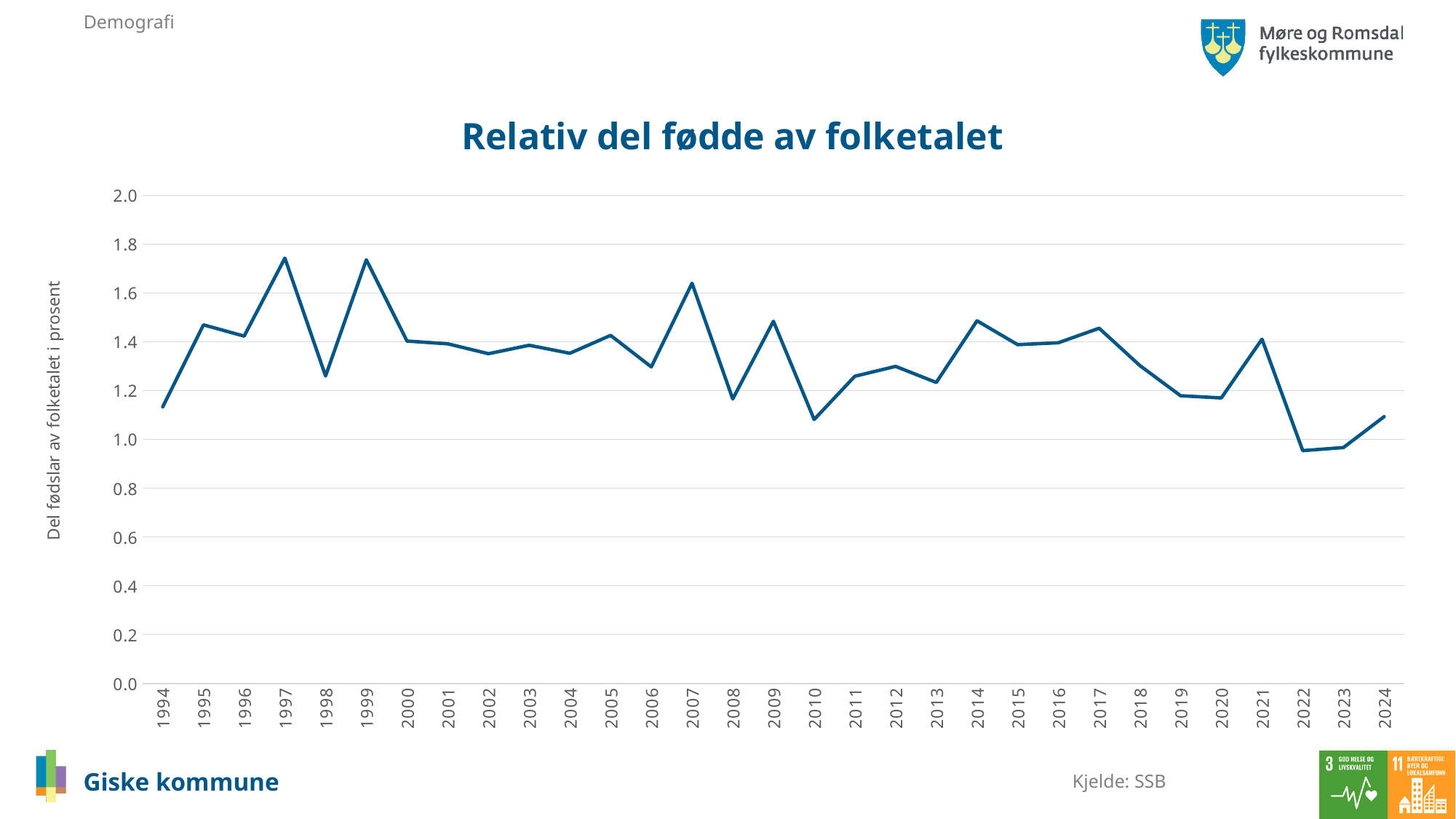
Is the value for 1994 greater or less than 1.0? greater Which year has the larger value, 2021 or 2022? 2021 Is the value for 1997 greater or less than 1.6? greater Does the value rise or fall from 2017 to 2019? fall Which year has the larger value, 2007 or 2008? 2007 What is the title of the chart? Relativ del fødde av folketalet Which year has the larger value, 1997 or 1998? 1997 Is the value for 2024 greater or less than 1.2? less How many years are plotted along the x axis of the chart? 31 What kind of chart is shown on the slide? line chart What is the label on the vertical axis of the chart? Del fødslar av folketalet i prosent